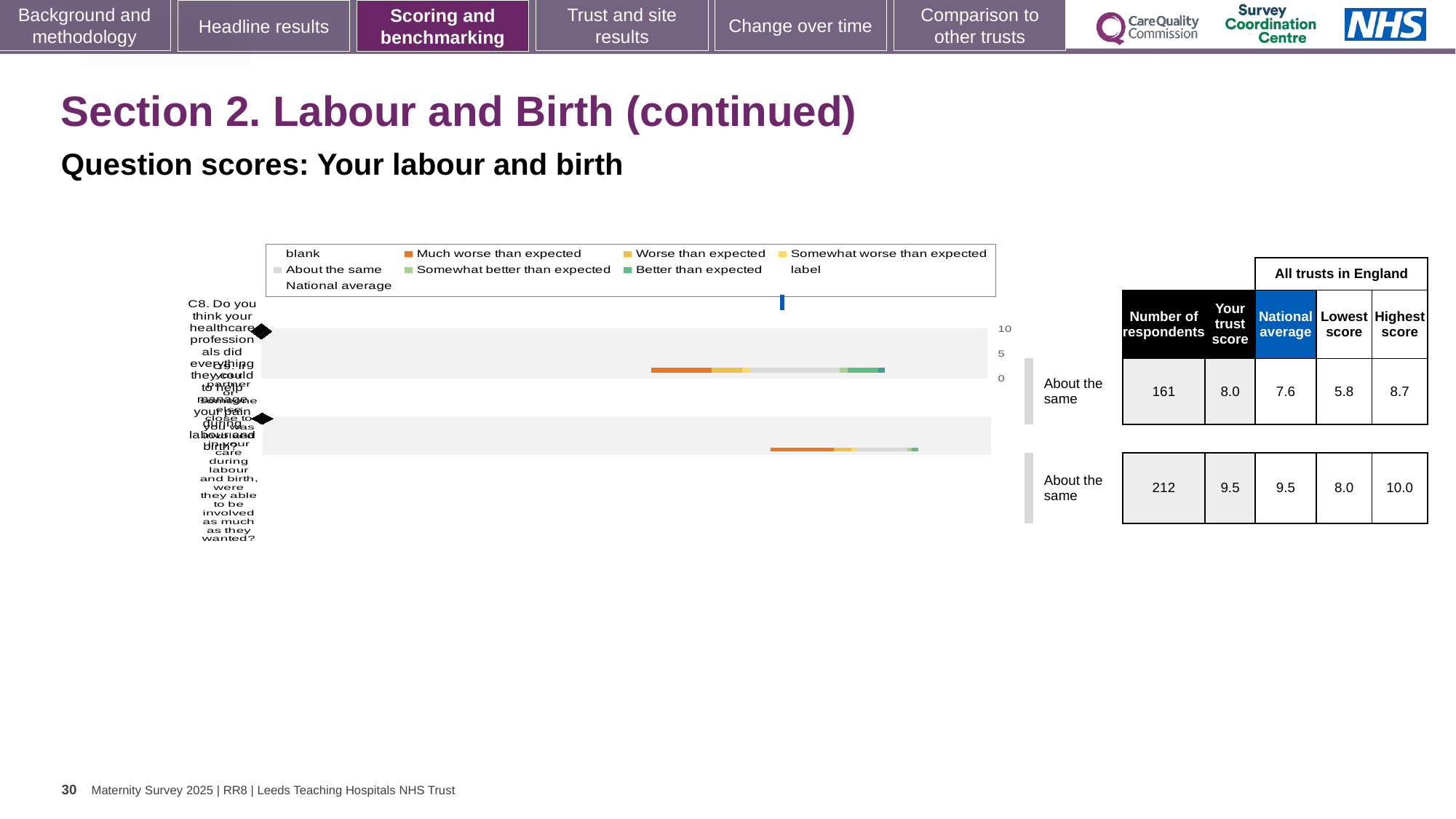
In the table beside the chart, what is 'Your trust score' for the first row? 8.0 In the chart legend, what colour represents 'Much worse than expected'? orange For the first row in the table, which is larger: your trust score or the national average? your trust score (8.0) In the table beside the chart, what is the difference between the highest score and the lowest score for the first row? 2.9 Which row in the table beside the chart has more respondents, the first or the second? the second (212) In the table beside the chart, what is the number of respondents for the first row? 161 In the table beside the chart, what is the highest score for the second row? 10.0 What kind of chart is shown on the slide? bar chart In the table beside the chart, what is the national average for the second row? 9.5 What benchmark category is shown next to the chart for the first row? About the same In the chart legend, what colour represents 'Better than expected'? green How many question rows (bars) are plotted in the chart? 2